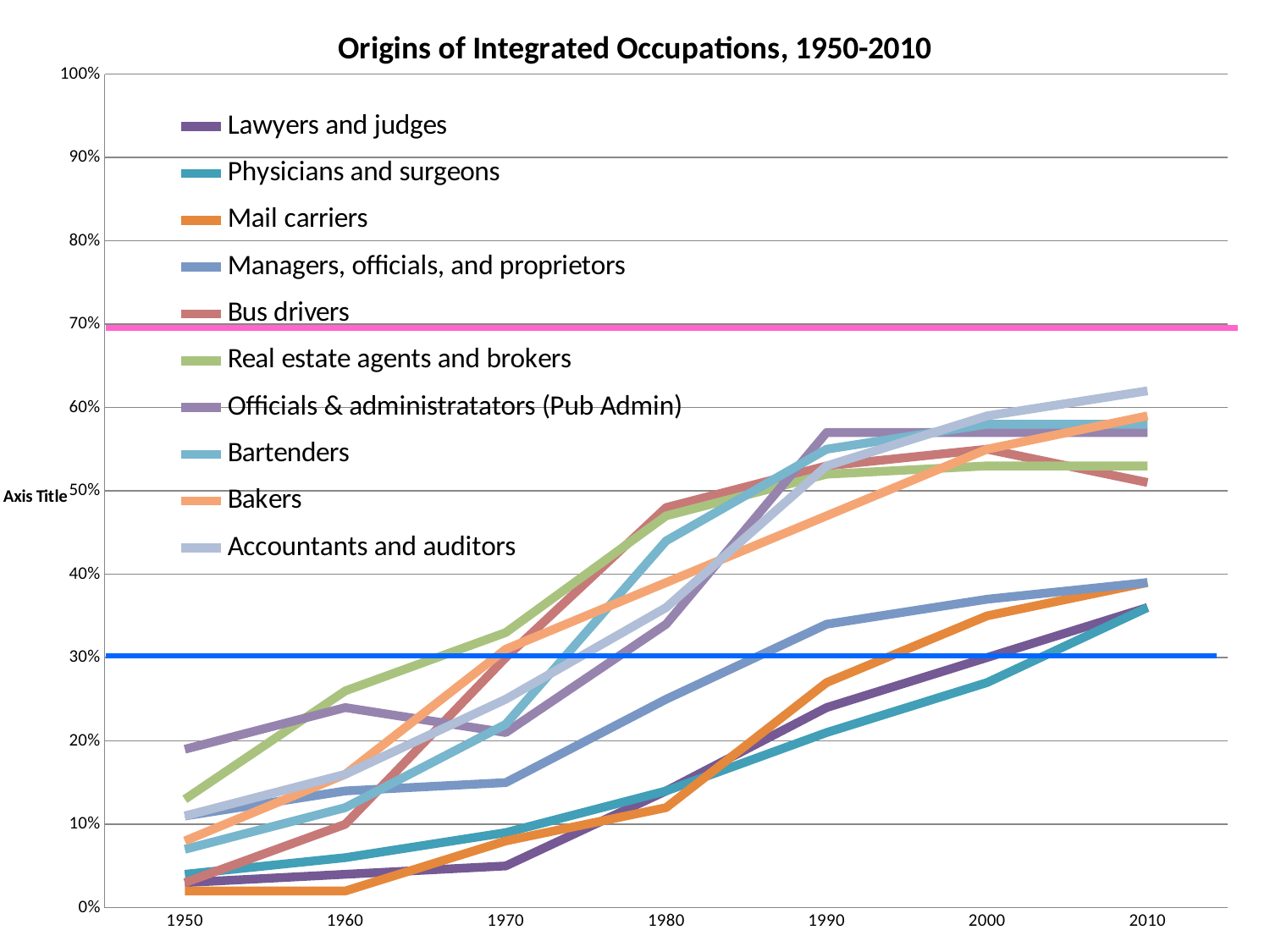
What kind of chart is shown on the slide? line chart Which is larger in 2010, Accountants and auditors or Managers, officials, and proprietors? Accountants and auditors What label is shown on the vertical axis? Axis Title Does the value for Lawyers and judges rise or fall from 1950 to 2010? rise Is the value for Real estate agents and brokers in 1960 greater or less than 20%? greater What is the title of the chart? Origins of Integrated Occupations, 1950-2010 How many series does the legend list? 10 How many years are marked along the x axis? 7 Which series has the highest value in 1950? Officials & administratators (Pub Admin) Which series has the highest value in 2010? Accountants and auditors Is the value for Lawyers and judges in 2010 greater or less than 30%? greater Is the value for Mail carriers in 1950 greater or less than 10%? less